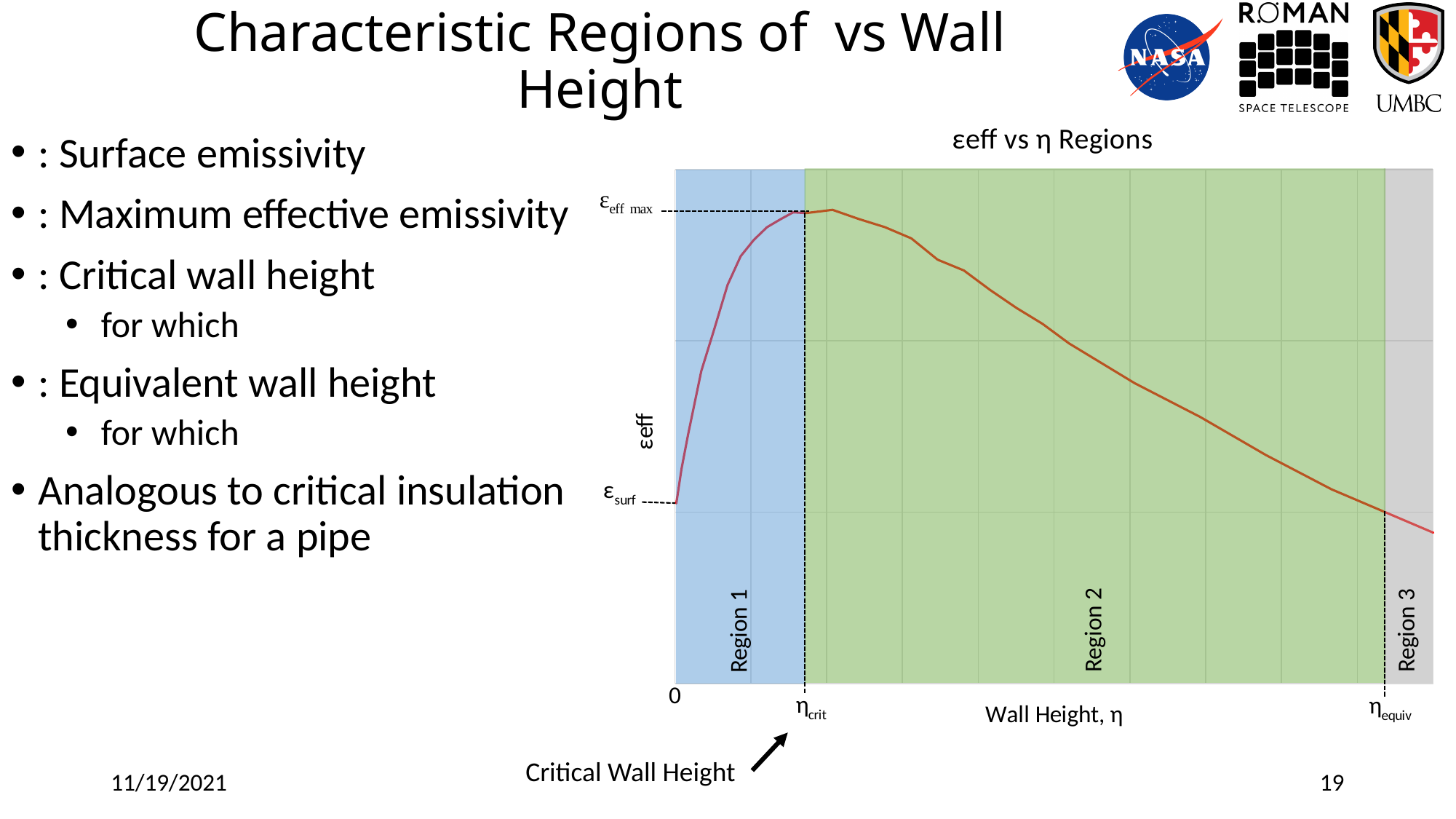
What is the title of the chart? εeff vs η Regions What is the value of εeff at wall height 0 on the chart? εsurf At which wall height does εeff reach its maximum on the chart? ηcrit What is the label of the x axis of the chart? Wall Height, η What label marks the maximum value of εeff on the y axis? εeff max Does εeff rise or fall as wall height increases within Region 2? fall Does εeff rise or fall as wall height increases within Region 1? rise What kind of chart is shown on the slide? line chart Which region spans the widest range of wall heights on the chart? Region 2 Is εeff at ηcrit greater or less than εeff at ηequiv? greater How many shaded regions are marked on the chart? 3 What x-axis label marks the boundary between Region 2 and Region 3? ηequiv